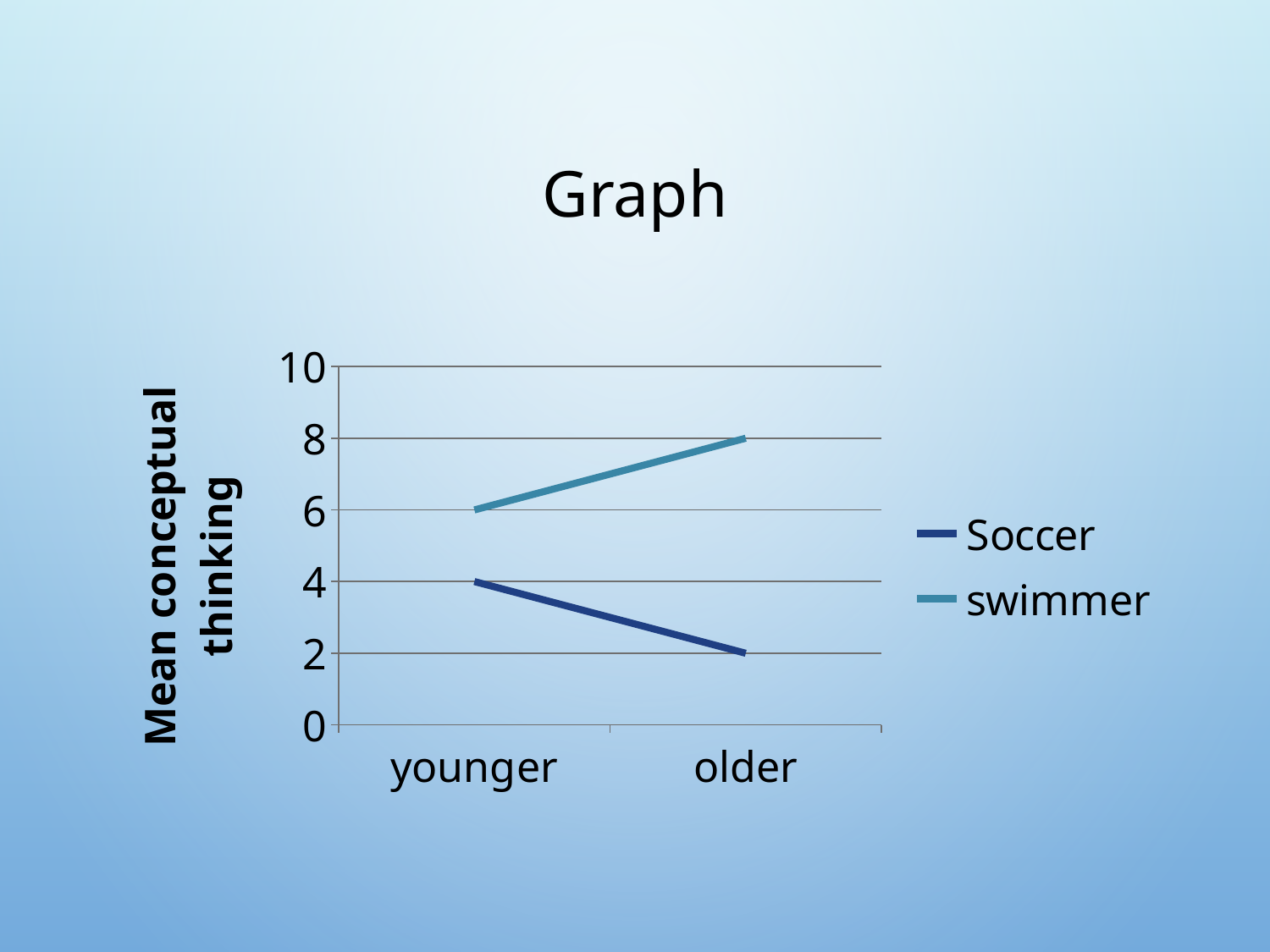
Which series has the higher value at younger, Soccer or swimmer? swimmer Does the Soccer line rise or fall from younger to older? fall How many series does the legend list? 2 What kind of chart is shown on the slide? line chart What is the value for Soccer at younger? 4 How many categories are shown on the x axis? 2 What is the value for swimmer at older? 8 What is the value for Soccer at older? 2 Does the swimmer line rise or fall from younger to older? rise What is the label of the vertical axis? Mean conceptual thinking What is the difference between the swimmer value and the Soccer value at older? 6 What is the value for swimmer at younger? 6